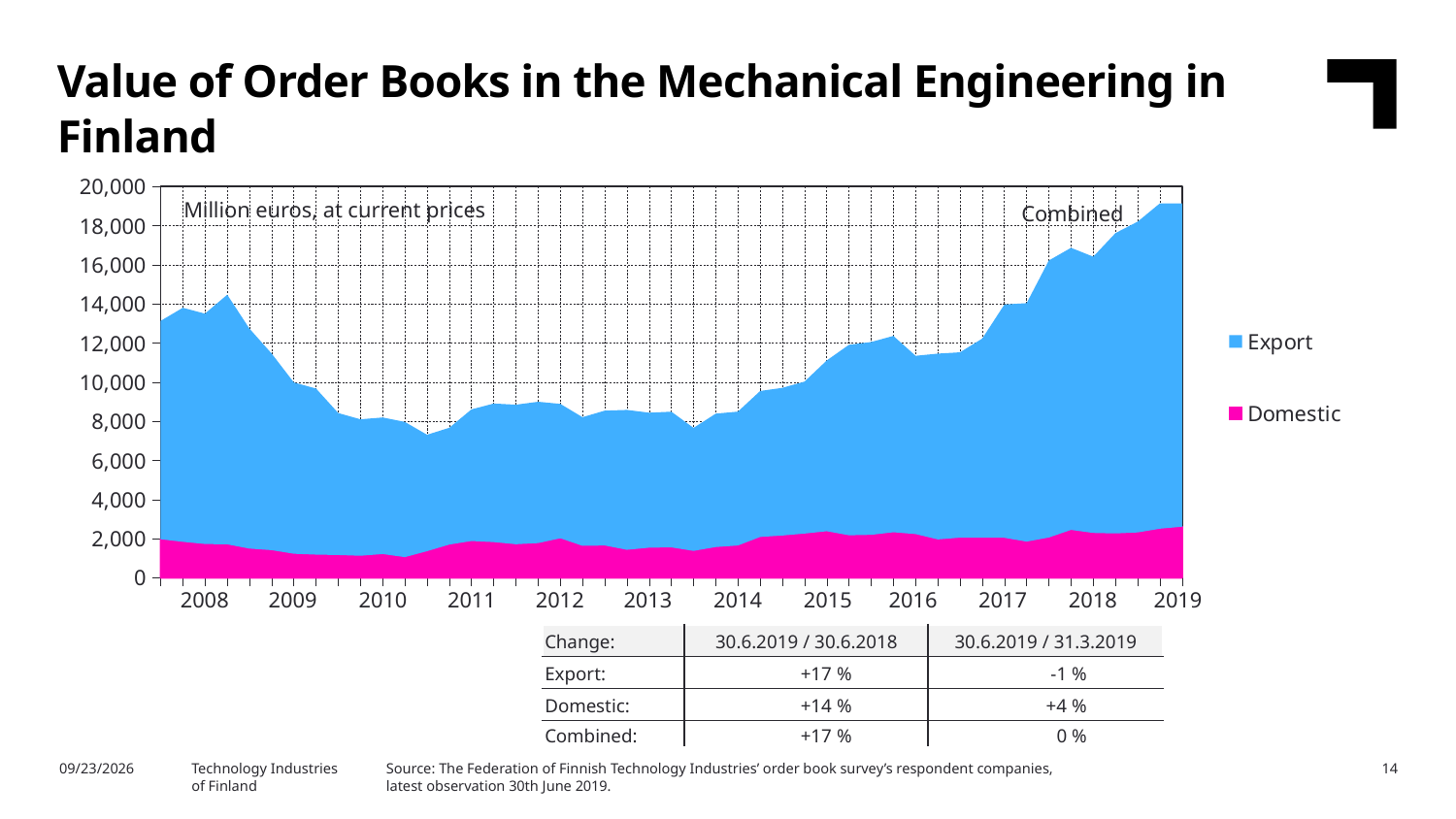
Is the Domestic value in 2010 greater or less than 2,000? less Which two series are listed in the chart legend? Export and Domestic Is the combined value of order books in 2013 greater or less than 10,000? less What kind of chart is shown on the slide? Stacked area chart How many series does the legend list? 2 Is the Domestic value at the end of 2019 greater or less than 2,000? greater Does the combined value of order books rise or fall between 2008 and 2010? fall Which year has the highest combined value of order books on the chart? 2019 In what unit are the values on the chart expressed, according to the note inside the plot area? Million euros, at current prices Does the combined value of order books rise or fall between 2016 and 2019? rise